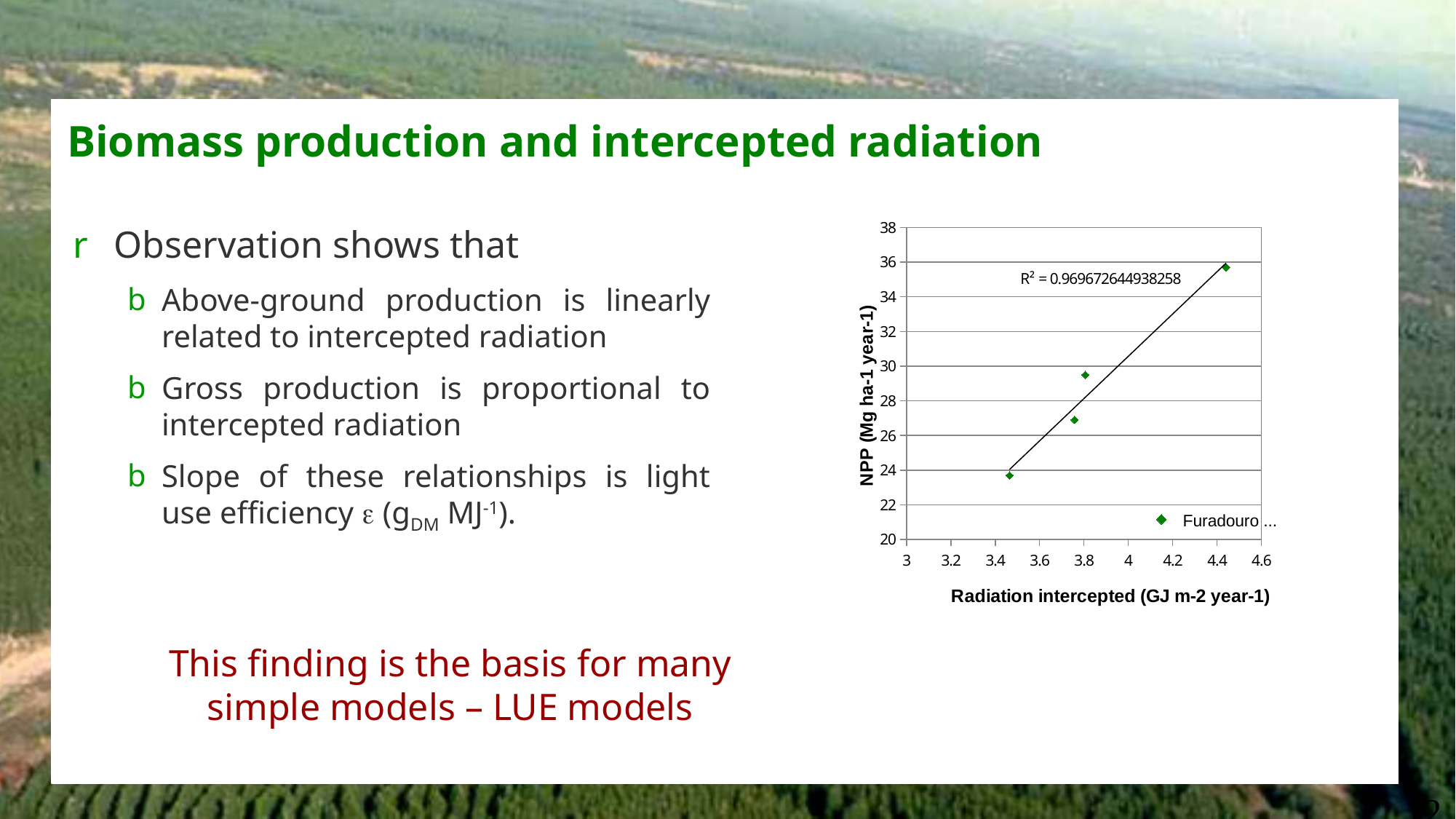
Is the highest NPP value plotted greater or less than 34? greater Do the NPP values rise or fall as radiation intercepted increases along the x axis? rise Is the radiation intercepted value of the lowest point greater or less than 3.6? less How many series does the chart legend list? 1 Which has the larger NPP: the point near 4.4 GJ m-2 year-1 or the point near 3.4 GJ m-2 year-1? the point near 4.4 What R² value is printed on the chart? R² = 0.969672644938258 What kind of chart is shown on the slide? scatter plot How many data points are plotted in the chart? 4 Is the radiation intercepted value of the highest point greater or less than 4.2? greater What is the title of the x axis of the chart? Radiation intercepted (GJ m-2 year-1)